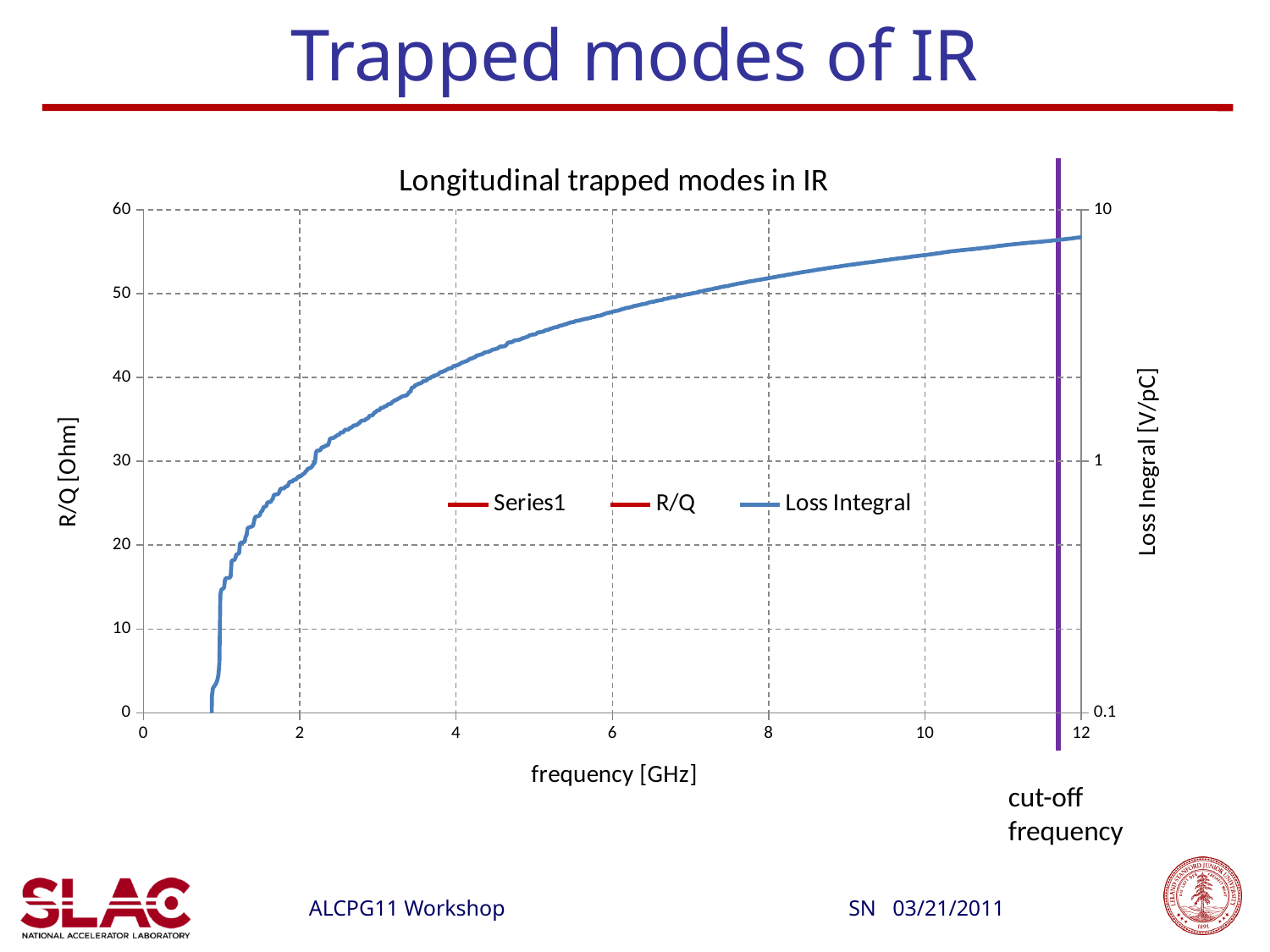
What is the title of the chart? Longitudinal trapped modes in IR What is the label of the x axis of the chart? frequency [GHz] Is the Loss Integral value at 4 GHz higher or lower than its value at 8 GHz? lower What is the maximum value shown on the left y axis (R/Q [Ohm]) of the chart? 60 What kind of chart is shown on the slide? line chart Is the Loss Integral value at 12 GHz greater or less than 10 V/pC on the right axis? less What is the maximum value shown on the x axis of the chart? 12 Is the Loss Integral value at 6 GHz greater or less than 1 V/pC on the right axis? greater Is the Loss Integral value at 10 GHz greater or less than 1 V/pC on the right axis? greater Does the Loss Integral curve rise or fall as frequency increases along the x axis? rise How many series does the legend of the chart list? 3